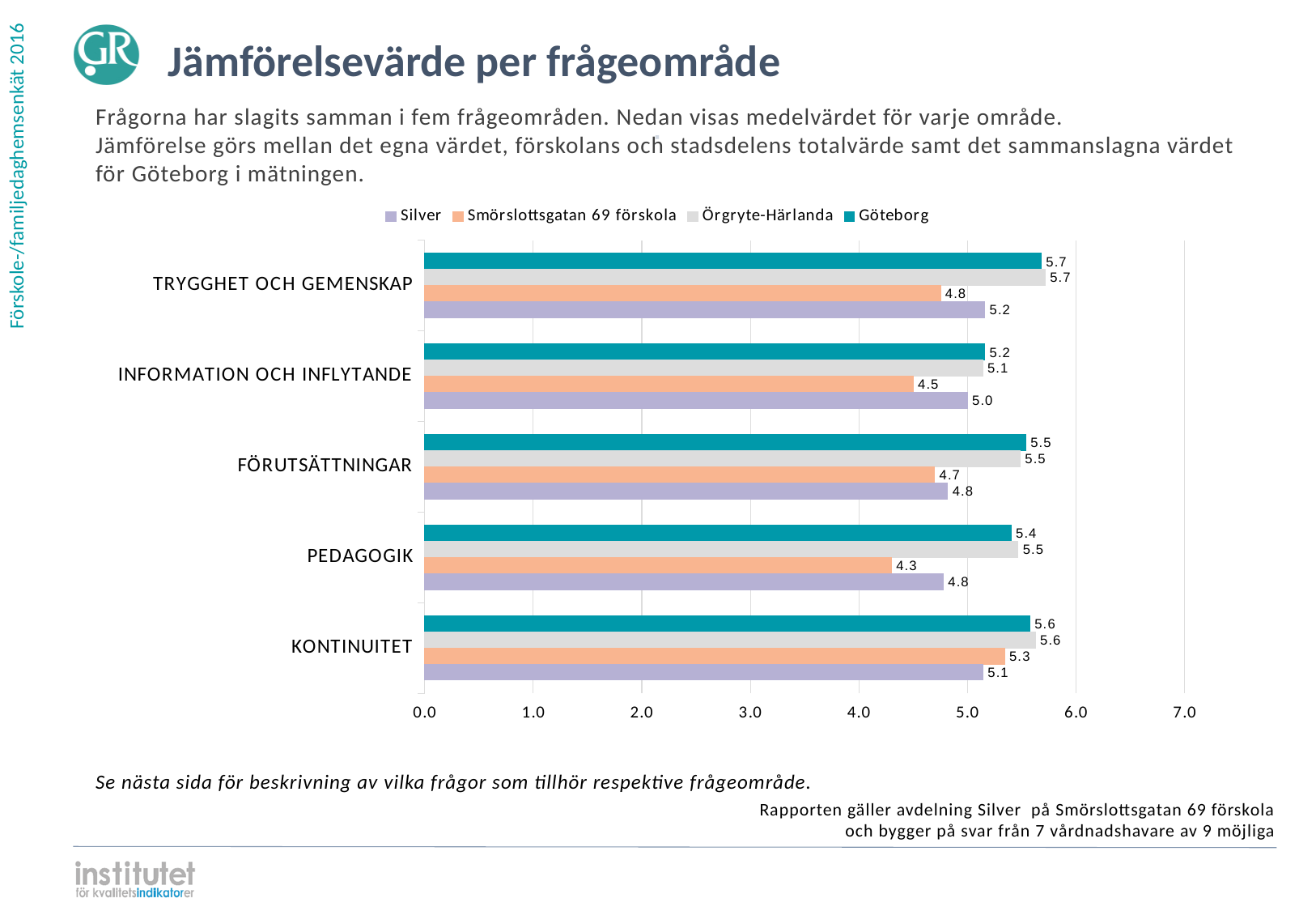
Is the value for Smörslottsgatan 69 förskola in INFORMATION OCH INFLYTANDE greater or less than 5.0? less What is the value for Silver in the KONTINUITET category? 5.1 How many series does the legend list? 4 What is the value for Smörslottsgatan 69 förskola in the PEDAGOGIK category? 4.3 What is the title of the slide? Jämförelsevärde per frågeområde How many categories (frågeområden) are shown on the chart? 5 What kind of chart is shown on the slide? bar chart In which category does Silver have its lowest value? FÖRUTSÄTTNINGAR and PEDAGOGIK (both 4.8) In which category does Smörslottsgatan 69 förskola have its highest value? KONTINUITET What is the value for Göteborg in the INFORMATION OCH INFLYTANDE category? 5.2 What is the difference between the Silver value and the Smörslottsgatan 69 förskola value in the TRYGGHET OCH GEMENSKAP category? 0.4 Which is larger in the PEDAGOGIK category: the Silver value or the Örgryte-Härlanda value? Örgryte-Härlanda